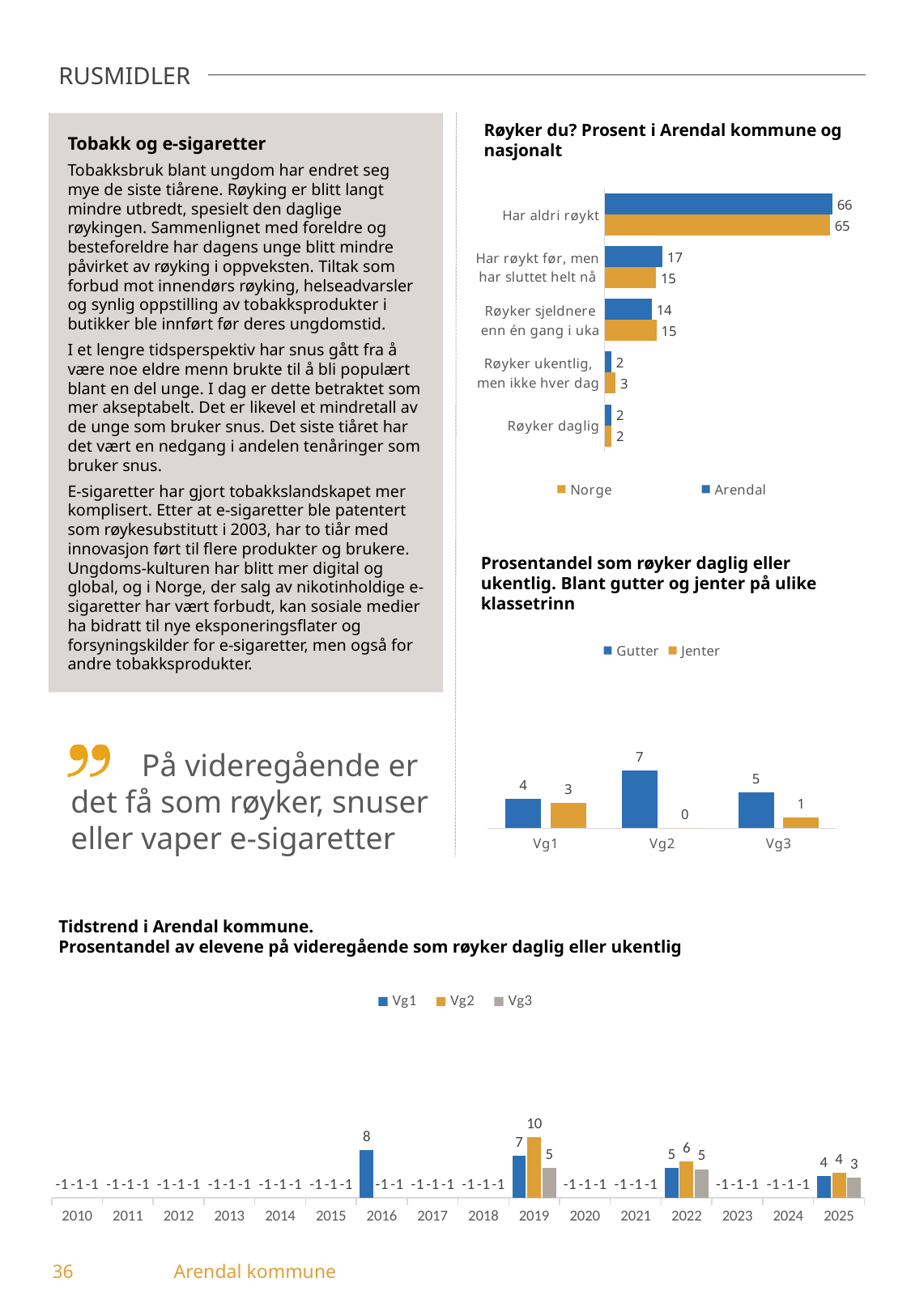
In the chart 'Prosentandel som røyker daglig eller ukentlig', which is larger at Vg3, Gutter or Jenter? Gutter In the chart 'Prosentandel som røyker daglig eller ukentlig', what is the value for Gutter at Vg2? 7 In the chart 'Røyker du? Prosent i Arendal kommune og nasjonalt', which category has the highest value for Arendal? Har aldri røykt In the chart 'Røyker du? Prosent i Arendal kommune og nasjonalt', how many series does the legend list? 2 What kind of chart is 'Tidstrend i Arendal kommune'? Bar chart In the chart 'Prosentandel som røyker daglig eller ukentlig', what is the value for Jenter at Vg2? 0 In the chart 'Prosentandel som røyker daglig eller ukentlig', how many categories are shown on the x axis? 3 In the chart 'Tidstrend i Arendal kommune', what is the value for Vg2 in 2019? 10 In the chart 'Røyker du? Prosent i Arendal kommune og nasjonalt', what is the value for Norge for 'Har røykt før, men har sluttet helt nå'? 15 In the chart 'Røyker du? Prosent i Arendal kommune og nasjonalt', what is the difference between Arendal and Norge for 'Har røykt før, men har sluttet helt nå'? 2 In the chart 'Røyker du? Prosent i Arendal kommune og nasjonalt', what is the value for Arendal for 'Har aldri røykt'? 66 In the chart 'Tidstrend i Arendal kommune', what is the value for Vg1 in 2016? 8